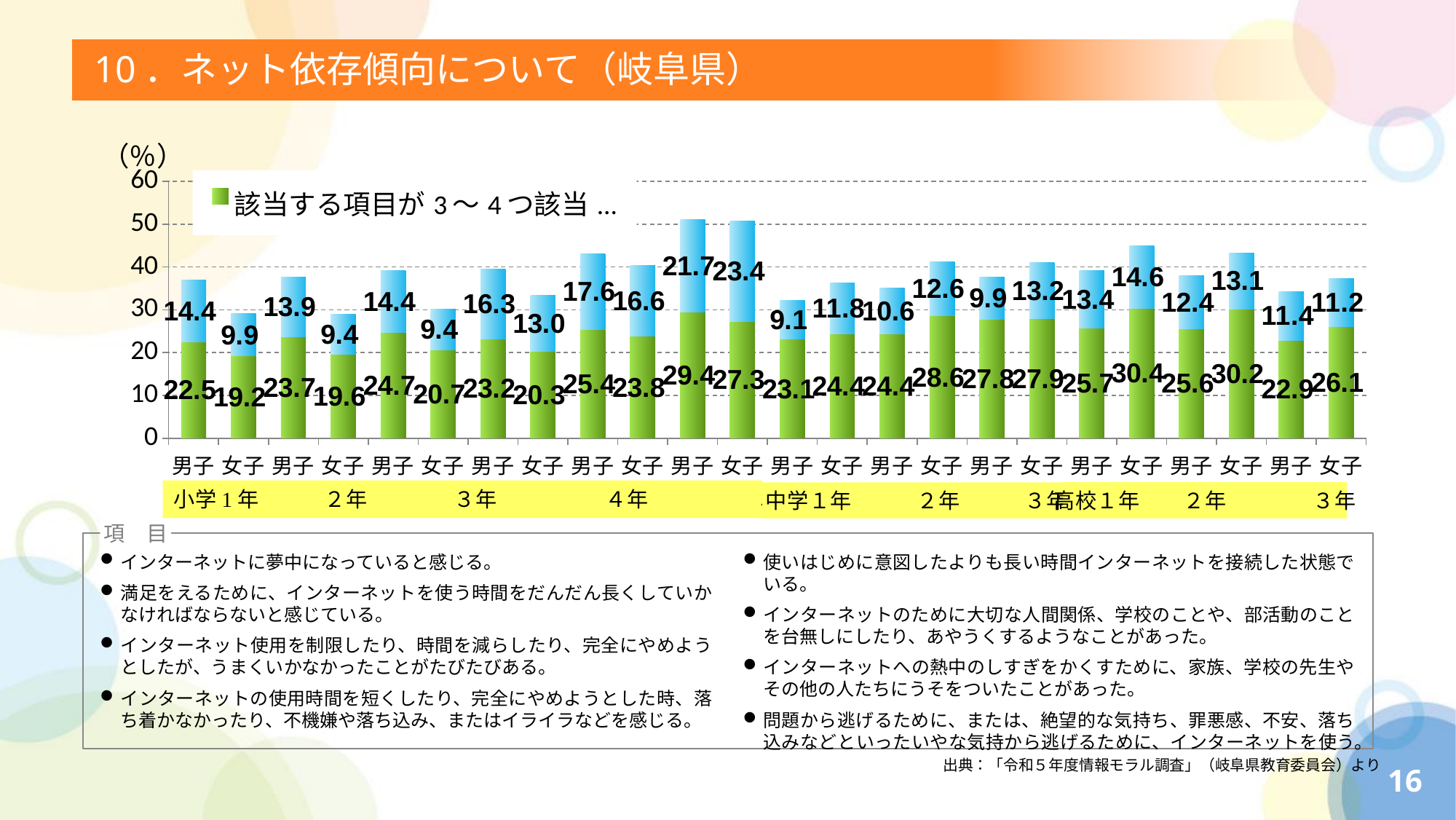
Which has the larger green value, 中学2年 男子 or 中学2年 女子? 中学2年 女子 What kind of chart is shown on the slide? Stacked bar chart Which bar has the lowest value in the green series? 小学1年 女子 What is the difference between the green values for 高校1年 女子 and 高校1年 男子? 4.7 Is the total height of the stacked bar for 高校1年 女子 greater or less than 40? greater What is the value of the green series (該当する項目が3～4つ該当) for 小学1年 男子? 22.5 What is the value of the blue (upper) segment for 中学1年 女子? 11.8 Which bar has the lowest value in the blue (upper) series? 中学1年 男子 How many bars are plotted in the chart? 24 Which bar has the highest value in the green series (該当する項目が3～4つ該当)? 高校1年 女子 What is the total of the stacked bar for 小学1年 男子? 36.9 What is the value of the green series for 高校3年 女子? 26.1